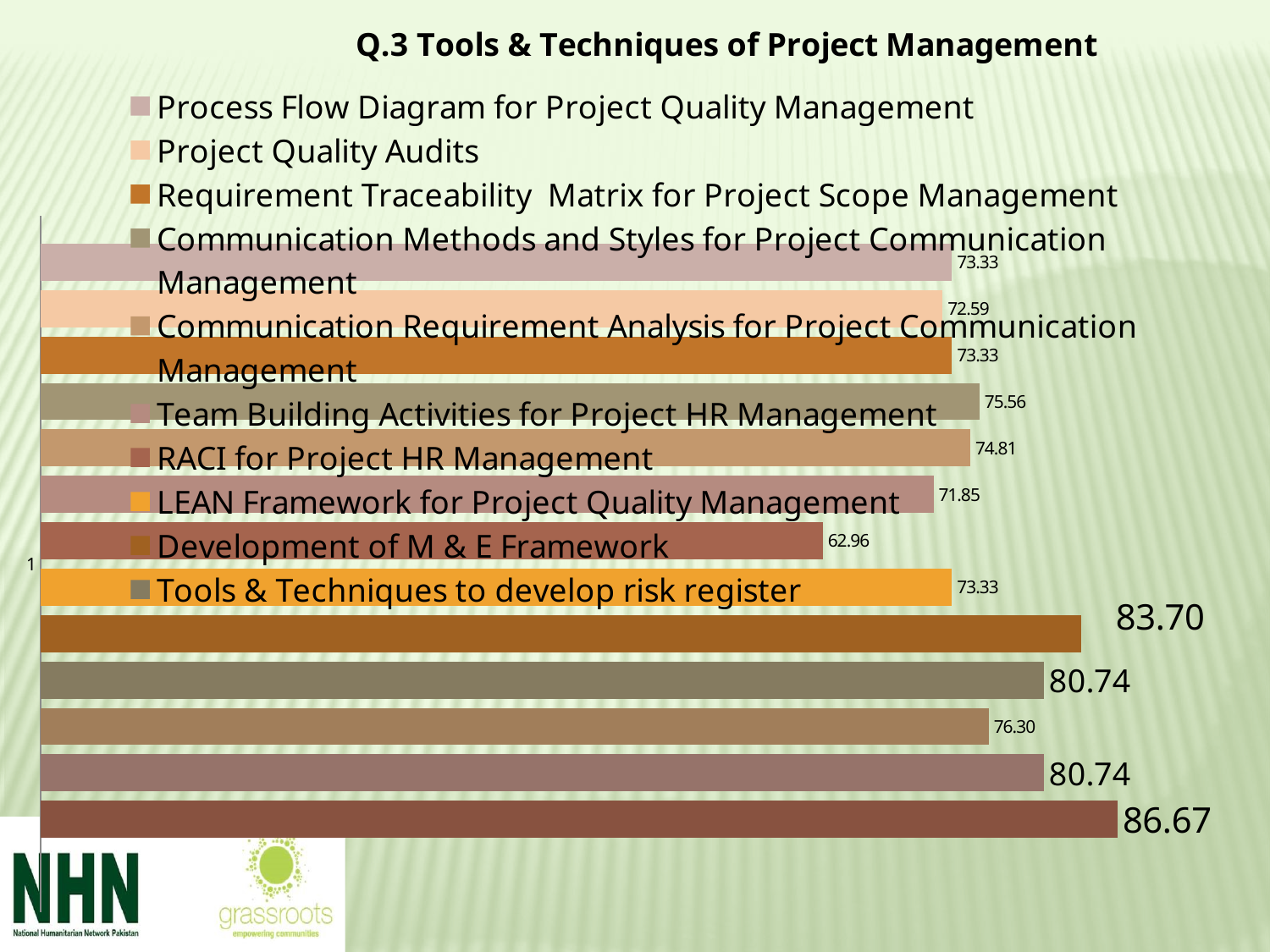
What is the difference between the highest bar value (86.67) and the lowest bar value (62.96)? 23.71 Which is larger, the value of the bottom bar or the value of the top bar? the bottom bar (86.67) How many bars are plotted in the chart? 13 What is the value labelled on the top bar of the chart? 73.33 How many entries does the chart's legend list? 10 What is the highest value shown on any bar in the chart? 86.67 What is the value labelled on the bottom bar of the chart? 86.67 How many bars in the chart are labelled 73.33? 3 What is the lowest value shown on any bar in the chart? 62.96 What is the first entry listed in the chart's legend? Process Flow Diagram for Project Quality Management What is the title of the chart? Q.3 Tools & Techniques of Project Management What kind of chart is shown on the slide? bar chart